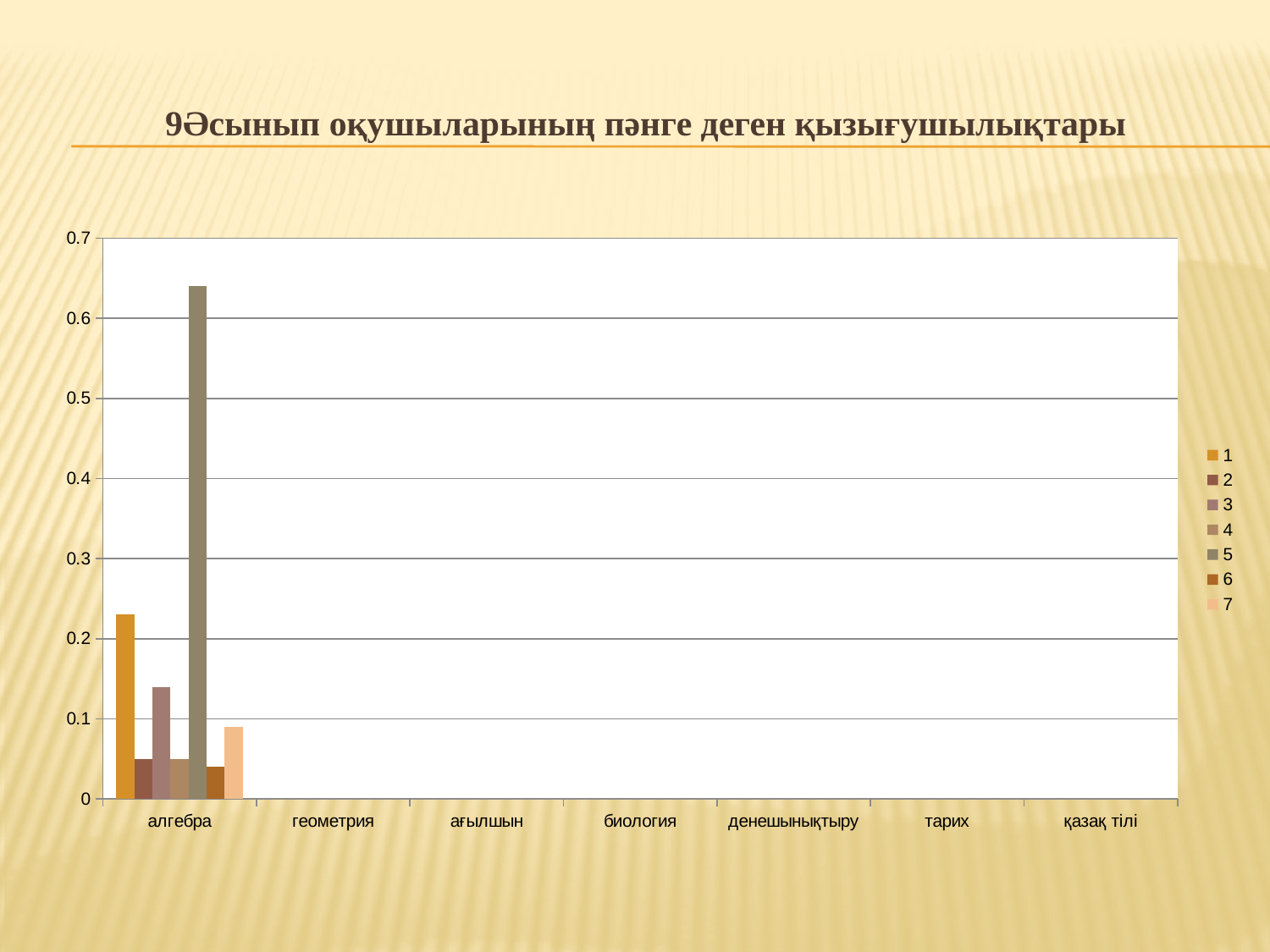
For алгебра, which is larger: the bar for series 1 or the bar for series 3? series 1 What is the title of the slide? 9Әсынып оқушыларының пәнге деген қызығушылықтары Which series has the tallest bar for алгебра? 5 For алгебра, which is larger: the bar for series 5 or the bar for series 1? series 5 Is the value for series 5 in алгебра greater or less than 0.6? greater Is the value for series 3 in алгебра greater or less than 0.1? greater How many series does the legend list? 7 Which category is the only one with visible bars? алгебра What kind of chart is shown on the slide? bar chart Is the value for series 1 in алгебра greater or less than 0.2? greater How many categories are shown on the x axis? 7